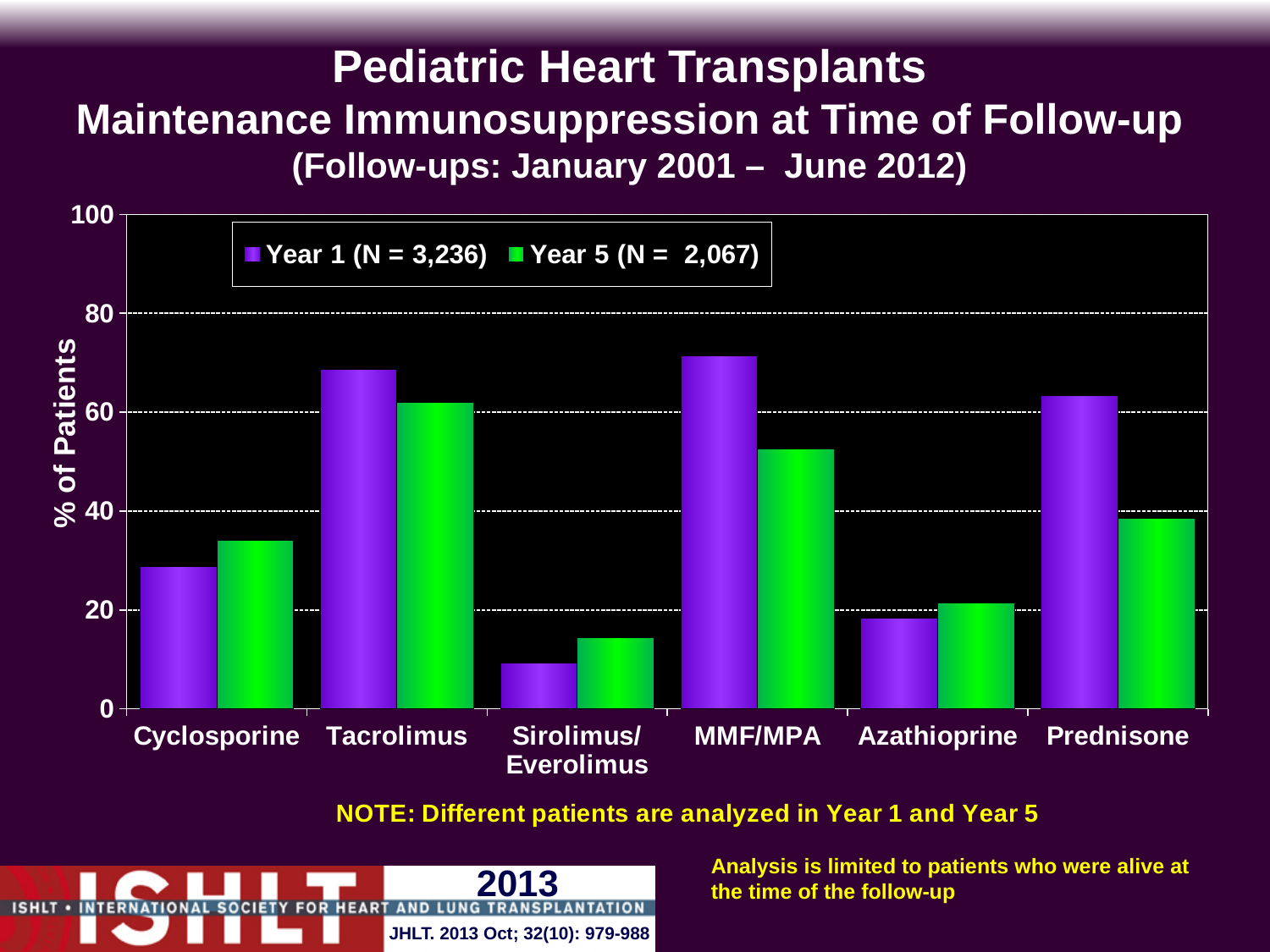
Is the Year 1 value for Tacrolimus greater or less than 60? greater Which drug has the lowest Year 1 percentage of patients? Sirolimus/Everolimus For Prednisone, which is larger: the Year 1 value or the Year 5 value? Year 1 Which drug has the highest Year 5 percentage of patients? Tacrolimus What is the label on the y axis? % of Patients Is the Year 1 value for Cyclosporine greater or less than 40? less Is the Year 5 value for MMF/MPA greater or less than 40? greater How many drug categories are shown on the x axis? 6 How many series does the legend list? 2 For Cyclosporine, which is larger: the Year 1 value or the Year 5 value? Year 5 Which drug has the lowest Year 5 percentage of patients? Sirolimus/Everolimus What kind of chart is shown on the slide? Bar chart